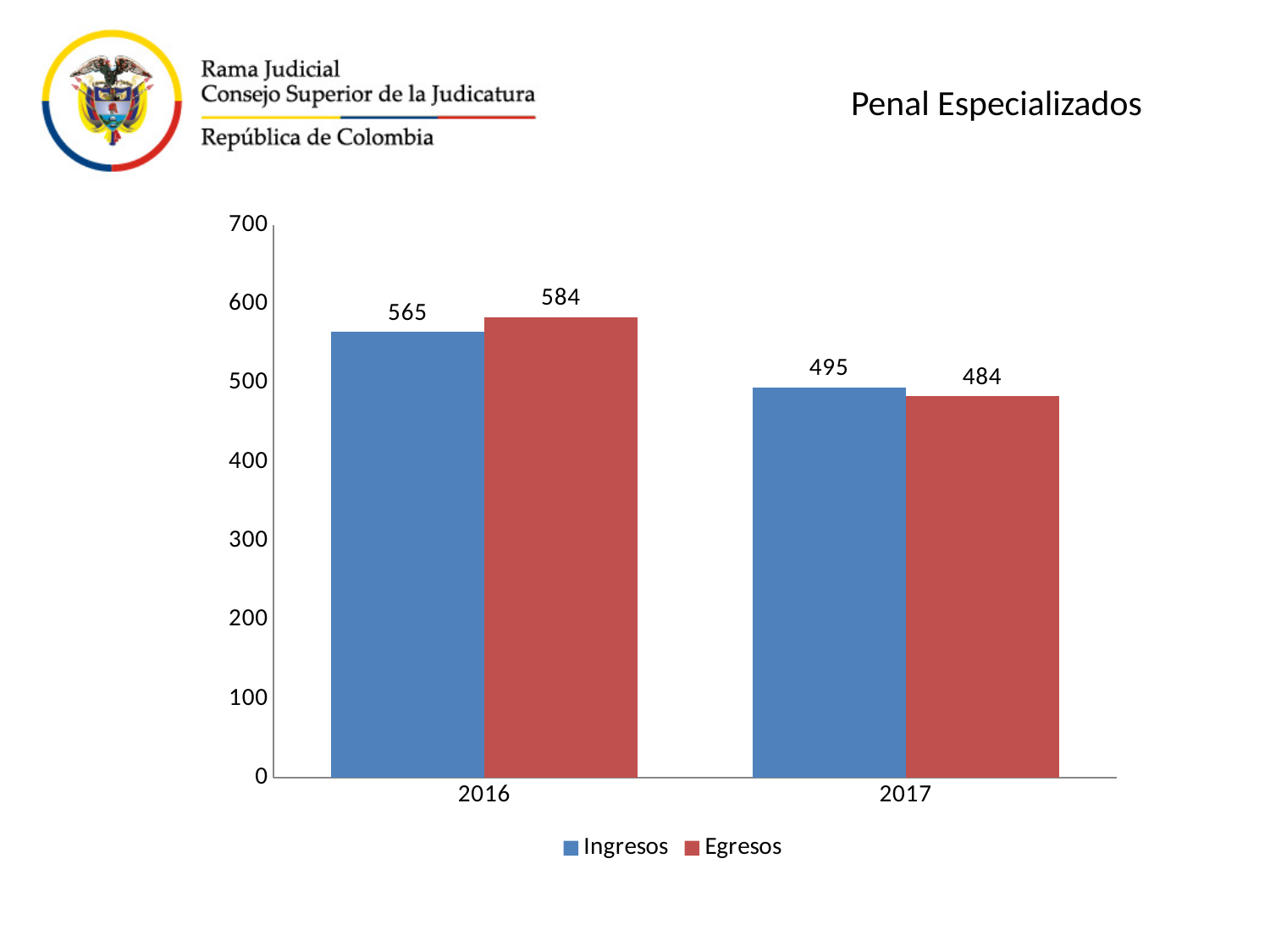
Which is larger in 2017, Ingresos or Egresos? Ingresos What kind of chart is shown on the slide? Bar chart What is the value of Egresos for 2017? 484 What is the value of Ingresos for 2017? 495 What is the value of Egresos for 2016? 584 Which year has the highest Ingresos value? 2016 How many series does the legend list? 2 What is the difference between Ingresos in 2016 and Ingresos in 2017? 70 What is the value of Ingresos for 2016? 565 Do the Egresos values rise or fall from 2016 to 2017? Fall What is the difference between Egresos and Ingresos in 2016? 19 Which year has the lowest Egresos value? 2017